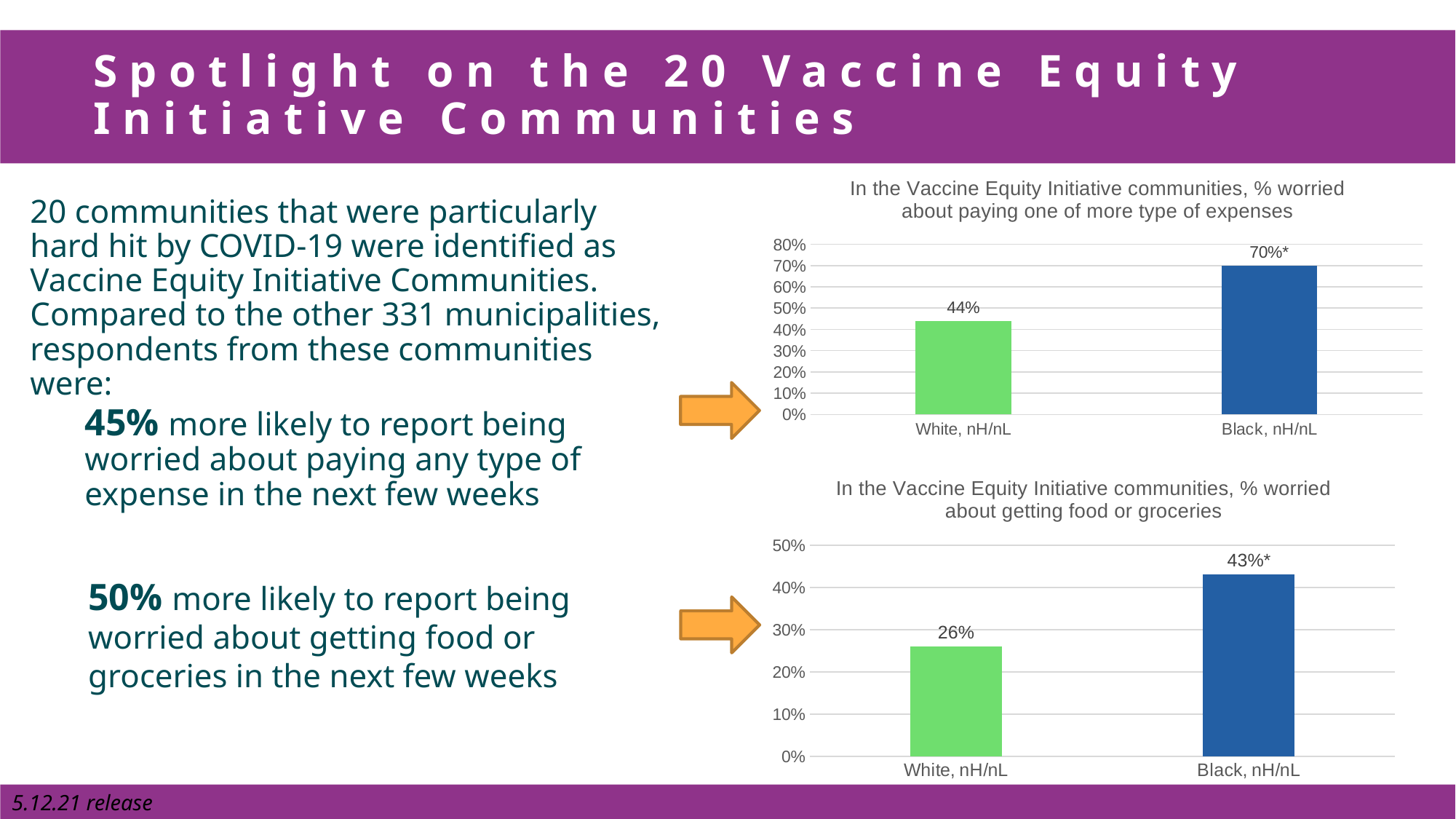
In the bottom chart (% worried about getting food or groceries), what is the difference between the Black, nH/nL and White, nH/nL values? 17 percentage points In the bottom chart (% worried about getting food or groceries), which category has the lowest value? White, nH/nL In the top chart (% worried about paying one of more type of expenses), what is the value for White, nH/nL? 44% In the top chart (% worried about paying one of more type of expenses), what is the difference between the Black, nH/nL and White, nH/nL values? 26 percentage points In the top chart (% worried about paying one of more type of expenses), what is the value for Black, nH/nL? 70%* How many categories are shown in the top chart (% worried about paying one of more type of expenses)? 2 In the bottom chart (% worried about getting food or groceries), what is the value for Black, nH/nL? 43%* In the bottom chart (% worried about getting food or groceries), is the value for White, nH/nL greater or less than 30%? less In the top chart (% worried about paying one of more type of expenses), what colour is the bar for Black, nH/nL? Blue In the top chart (% worried about paying one of more type of expenses), which category has the highest value? Black, nH/nL In the bottom chart (% worried about getting food or groceries), what is the value for White, nH/nL? 26% What kind of chart is the bottom chart (% worried about getting food or groceries)? Bar chart